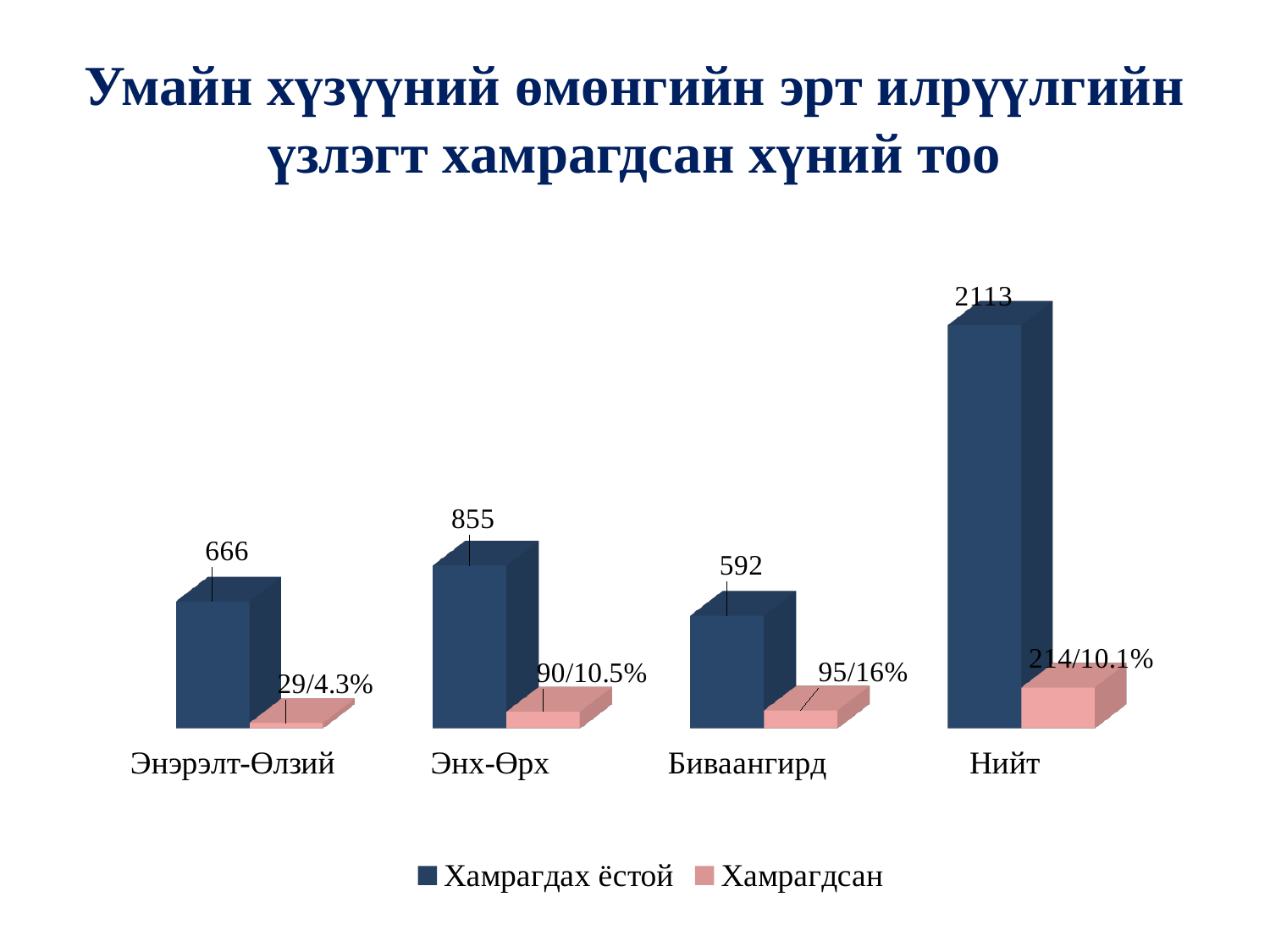
Which category has the highest Хамрагдах ёстой value? Нийт What kind of chart is shown on the slide? Bar chart What data label is shown for Хамрагдсан at Биваангирд? 95/16% What are the two series names in the legend? Хамрагдах ёстой and Хамрагдсан What is the difference between the Хамрагдах ёстой values for Энх-Өрх and Энэрэлт-Өлзий? 189 What data label is shown for Хамрагдсан at Энэрэлт-Өлзий? 29/4.3% What is the value of Хамрагдах ёстой for Энх-Өрх? 855 Which category has the lowest Хамрагдах ёстой value? Биваангирд What is the value of Хамрагдах ёстой for Нийт? 2113 How many categories are shown on the x axis? 4 How many series does the legend list? 2 Which is larger, the Хамрагдах ёстой value for Энэрэлт-Өлзий or for Биваангирд? Энэрэлт-Өлзий